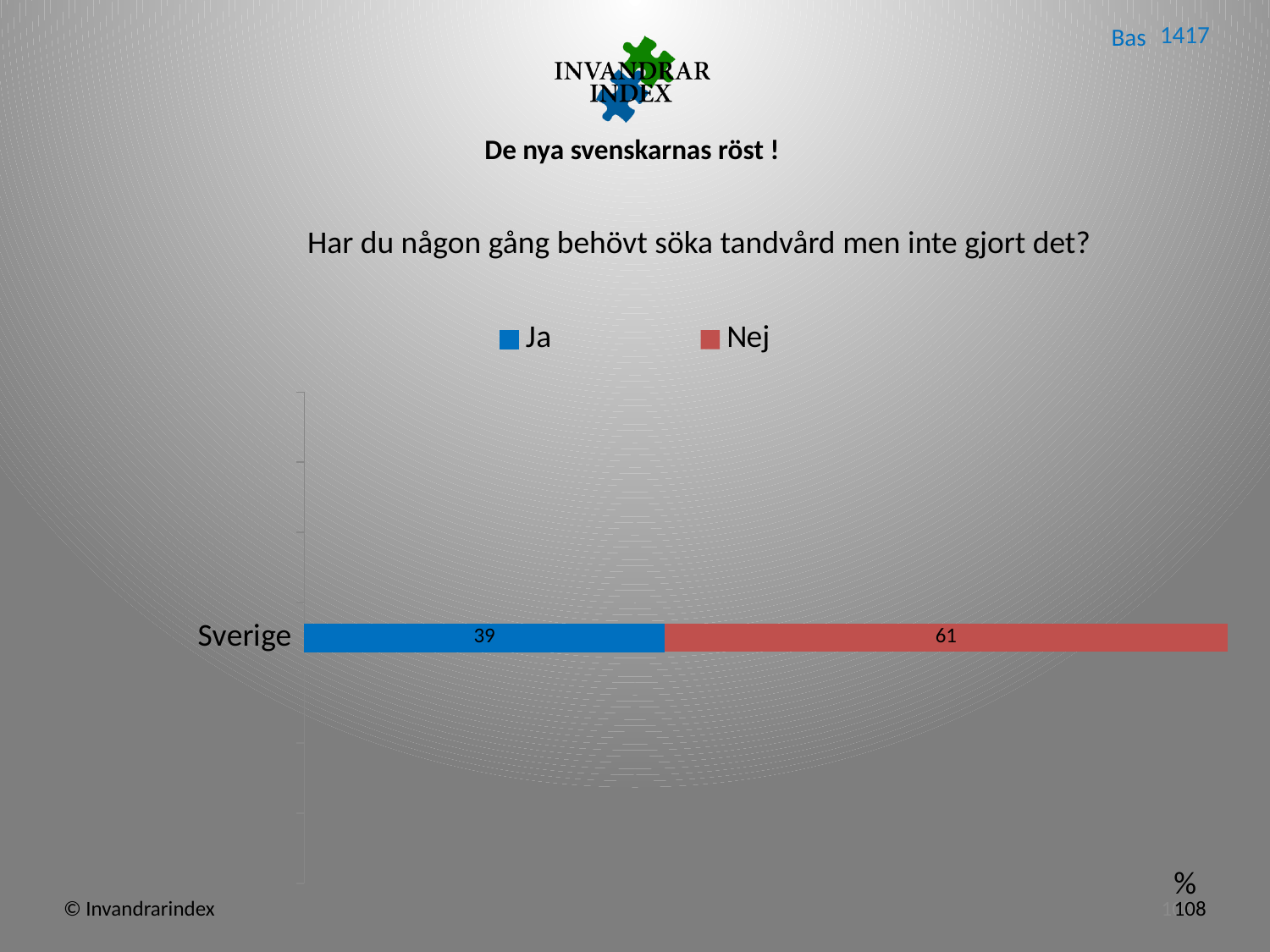
What is the value for Ja for Sverige? 39 What is the total of the stacked bar for Sverige? 100 What kind of chart is shown on the slide? Stacked bar chart What is the difference between the Nej and Ja values for Sverige? 22 How many series does the legend list? 2 What is the name of the category shown on the chart? Sverige What is the value for Nej for Sverige? 61 Which series has the larger value for Sverige, Ja or Nej? Nej Is the value for Ja for Sverige greater or less than 50? less How many categories are shown on the chart? 1 Which colour represents Ja in the legend? Blue